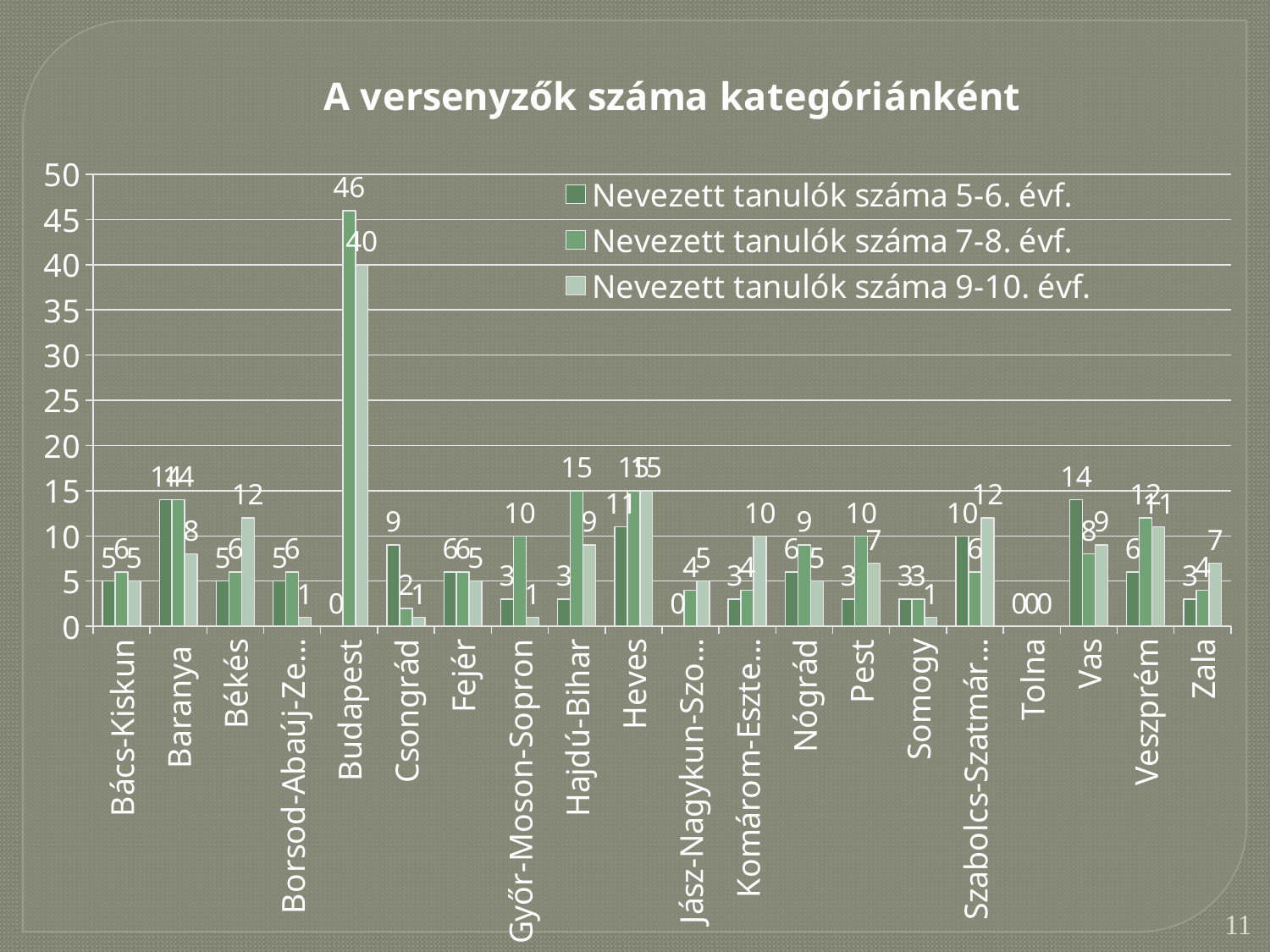
What is the title of the chart? A versenyzők száma kategóriánként What is the difference between the 7-8. évf. value and the 9-10. évf. value for Budapest? 6 What is the value for Csongrád in the series "Nevezett tanulók száma 5-6. évf."? 9 Which category has the highest value in the series "Nevezett tanulók száma 7-8. évf."? Budapest How many series does the legend list? 3 What is the value for Budapest in the series "Nevezett tanulók száma 7-8. évf."? 46 What is the value for Tolna in the series "Nevezett tanulók száma 9-10. évf."? 0 How many categories are shown on the x axis? 20 What kind of chart is shown on the slide? bar chart What is the value for Heves in the series "Nevezett tanulók száma 5-6. évf."? 11 For Vas, which is larger: the 5-6. évf. value or the 7-8. évf. value? 5-6. évf. What is the value for Budapest in the series "Nevezett tanulók száma 9-10. évf."? 40